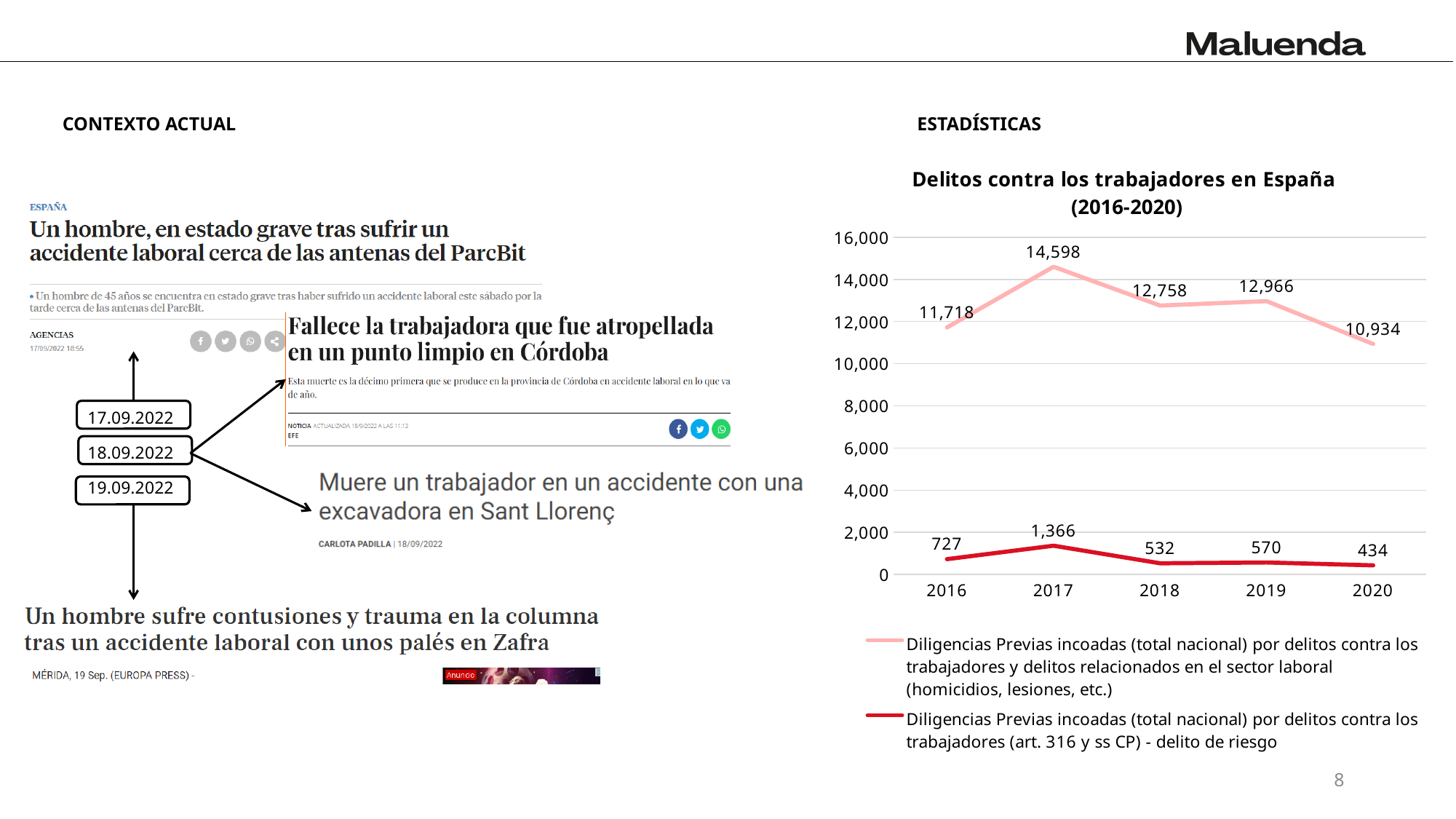
In which year is the total series (homicidios, lesiones, etc.) highest? 2017 What is the value of the 'delito de riesgo' (art. 316 y ss CP) series in 2017? 1,366 How many series does the legend of the chart list? 2 What is the value of the total series (homicidios, lesiones, etc.) in 2020? 10,934 What type of chart is shown under 'Delitos contra los trabajadores en España (2016-2020)'? line chart What is the difference between the total series values in 2017 and 2016? 2,880 Is the total series value in 2020 greater or less than 12,000? less How many years are plotted on the x axis of the chart? 5 In which year is the 'delito de riesgo' series lowest? 2020 What is the difference between the 'delito de riesgo' values in 2019 and 2018? 38 Which is larger for the total series: the value in 2018 or the value in 2019? 2019 What is the title of the chart? Delitos contra los trabajadores en España (2016-2020)